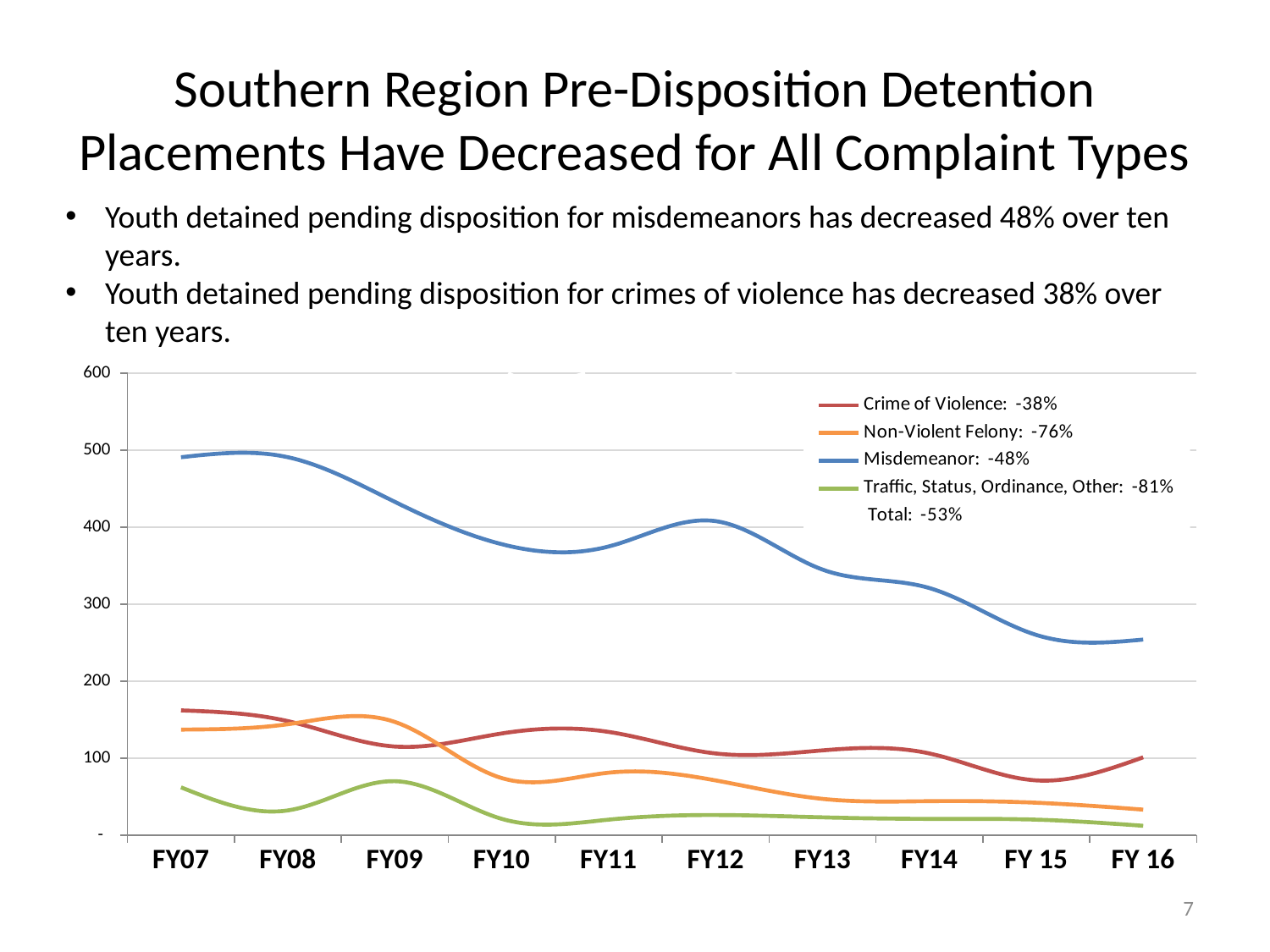
Is the Non-Violent Felony value for FY 16 greater or less than 100? less How many series does the legend list? 5 Which series has the lowest value at FY 16? Traffic, Status, Ordinance, Other Is the Misdemeanor value for FY07 greater or less than 400? greater What percentage change does the legend show for Non-Violent Felony? -76% At FY 16, which is larger: Crime of Violence or Non-Violent Felony? Crime of Violence Which series has the highest value at FY07? Misdemeanor What kind of chart is shown on the slide? line chart Is the Crime of Violence value for FY07 greater or less than 100? greater Does the Misdemeanor line rise or fall overall from FY07 to FY 16? fall How many fiscal years are plotted along the x axis? 10